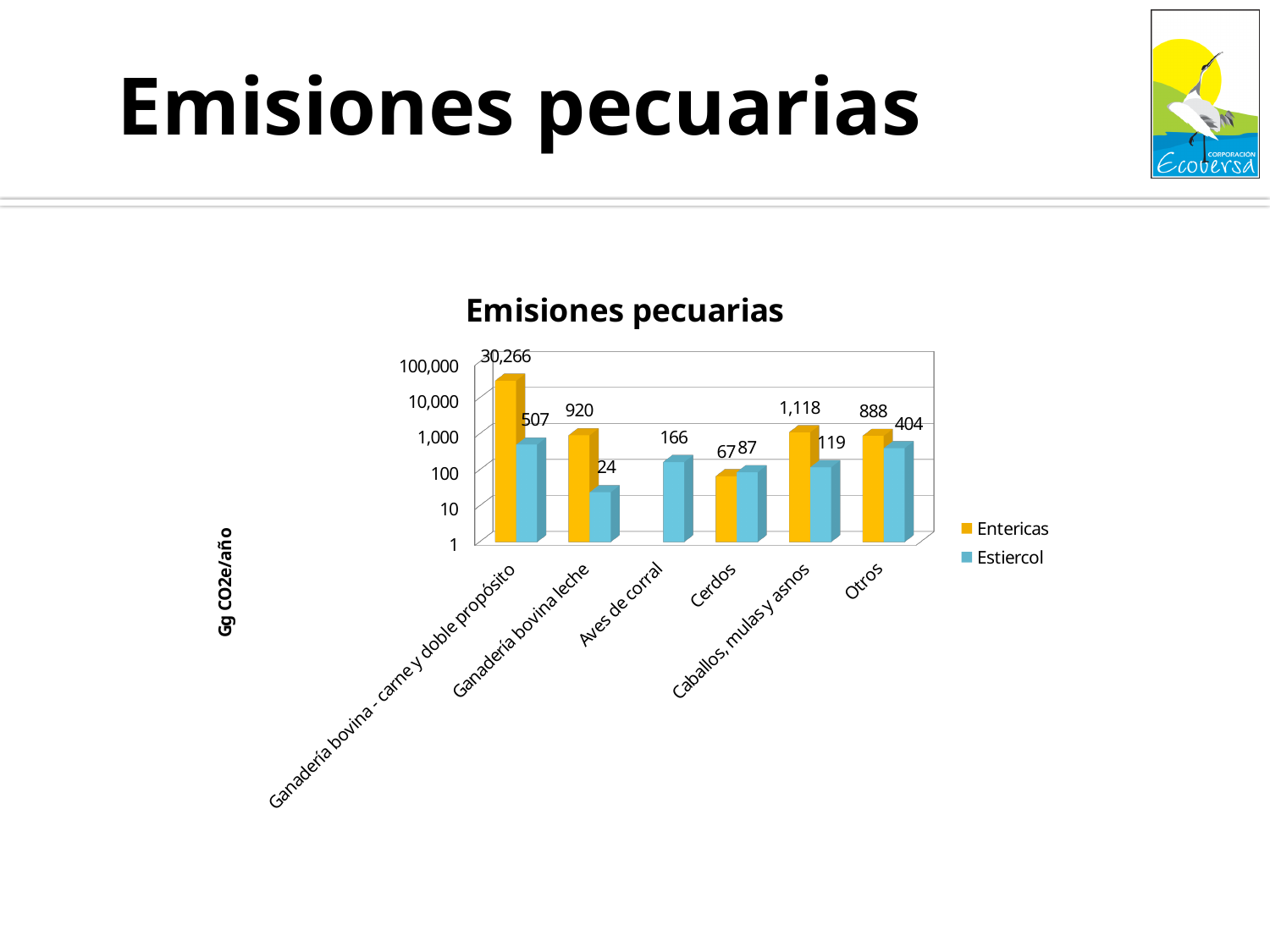
Which category has the lowest Estiercol value? Ganadería bovina leche What is the difference between the Entericas and Estiercol values for Otros? 484 How many series does the legend list? 2 For Cerdos, which is larger: the Entericas value or the Estiercol value? Estiercol What is the Entericas value for Ganadería bovina - carne y doble propósito? 30,266 What is the Estiercol value for Aves de corral? 166 Which category has the highest Entericas value? Ganadería bovina - carne y doble propósito What kind of chart is shown on the slide? Bar chart What is the Entericas value for Caballos, mulas y asnos? 1,118 What is the Estiercol value for Ganadería bovina leche? 24 What is the label on the vertical axis of the chart? Gg CO2e/año How many categories are shown on the x axis? 6